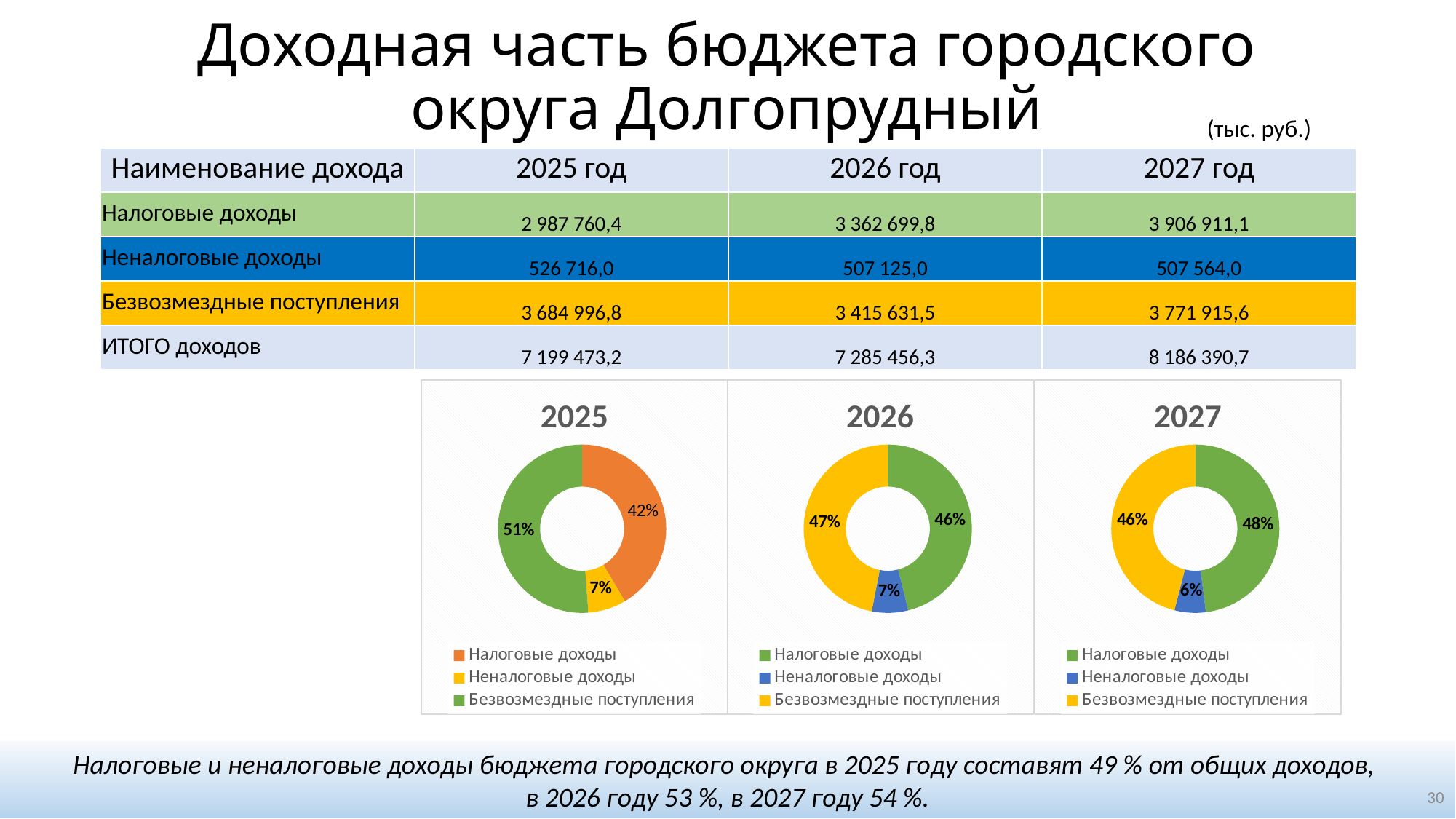
In the 2027 chart, which category has the largest share? Налоговые доходы In the 2025 chart, which category has the largest share? Безвозмездные поступления In the 2027 chart, what share does Налоговые доходы have? 48% In the 2025 chart, what colour is the Налоговые доходы slice? Orange In the 2026 chart, what share does Неналоговые доходы have? 7% In the 2025 chart, which is larger: the share of Налоговые доходы or the share of Безвозмездные поступления? Безвозмездные поступления In the 2027 chart, which category has the smallest share? Неналоговые доходы How many categories does the legend of the 2027 chart list? 3 In the 2025 chart, what share does Безвозмездные поступления have? 51% In the 2026 chart, what is the difference between the shares of Безвозмездные поступления and Налоговые доходы? 1% What kind of chart is the 2026 chart? Donut (pie) chart In the 2025 chart, what share does Налоговые доходы have? 42%